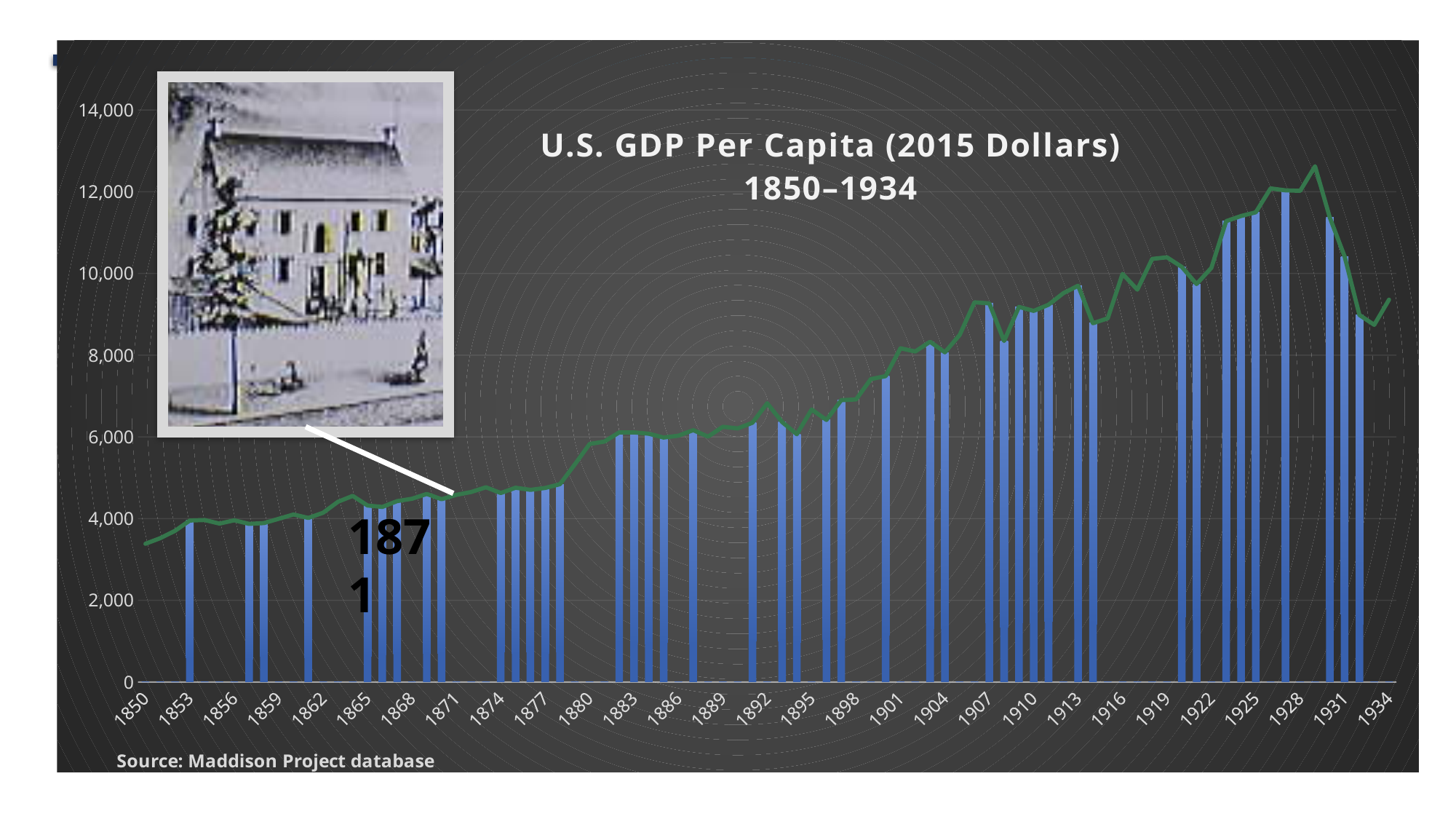
Is the value for 1925 greater or less than 10,000? greater What source is cited for the chart data? Maddison Project database What kind of chart is shown on the slide? A combined bar and line chart Which is larger, the value for 1901 or the value for 1913? 1913 What is the title of the chart? U.S. GDP Per Capita (2015 Dollars) 1850–1934 Is the value for 1913 greater or less than 8,000? greater Which is larger, the value for 1931 or the value for 1934? 1931 Is the value for 1934 greater or less than 10,000? less Which year has the lowest value on the chart? 1850 Overall, do the values rise or fall from 1850 to 1934? Rise